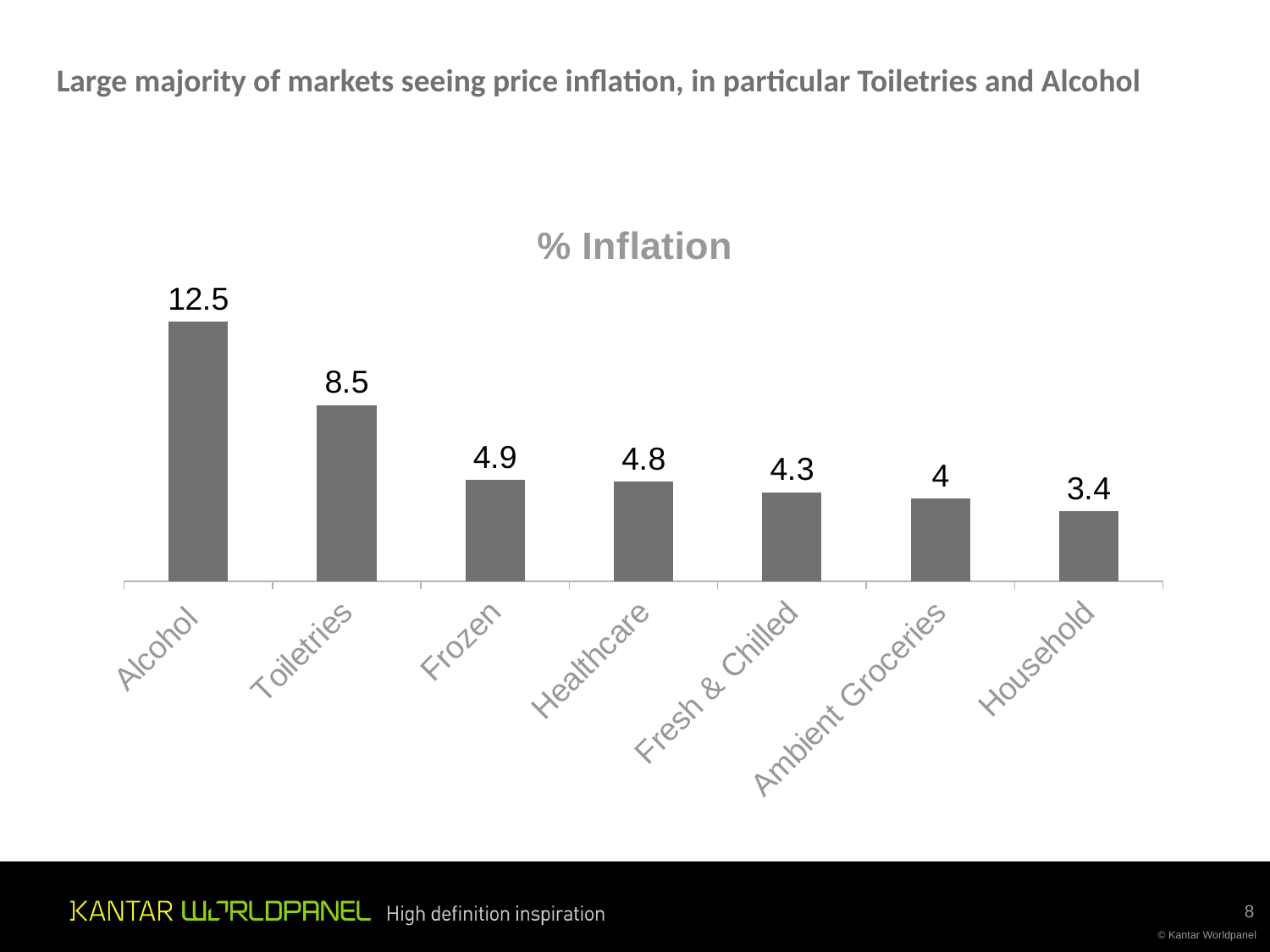
What kind of chart is shown on the slide? Bar chart What is the difference in % Inflation between Alcohol and Toiletries? 4 What is the difference in % Inflation between Frozen and Household? 1.5 What is the % Inflation value for Ambient Groceries? 4 What is the % Inflation value for Toiletries? 8.5 How many categories are shown in the chart? 7 Do the values rise or fall from left to right across the categories? Fall What is the % Inflation value for Alcohol? 12.5 What is the % Inflation value for Household? 3.4 Which category has the lowest % Inflation? Household Which has a higher % Inflation, Toiletries or Fresh & Chilled? Toiletries Which category has the highest % Inflation? Alcohol